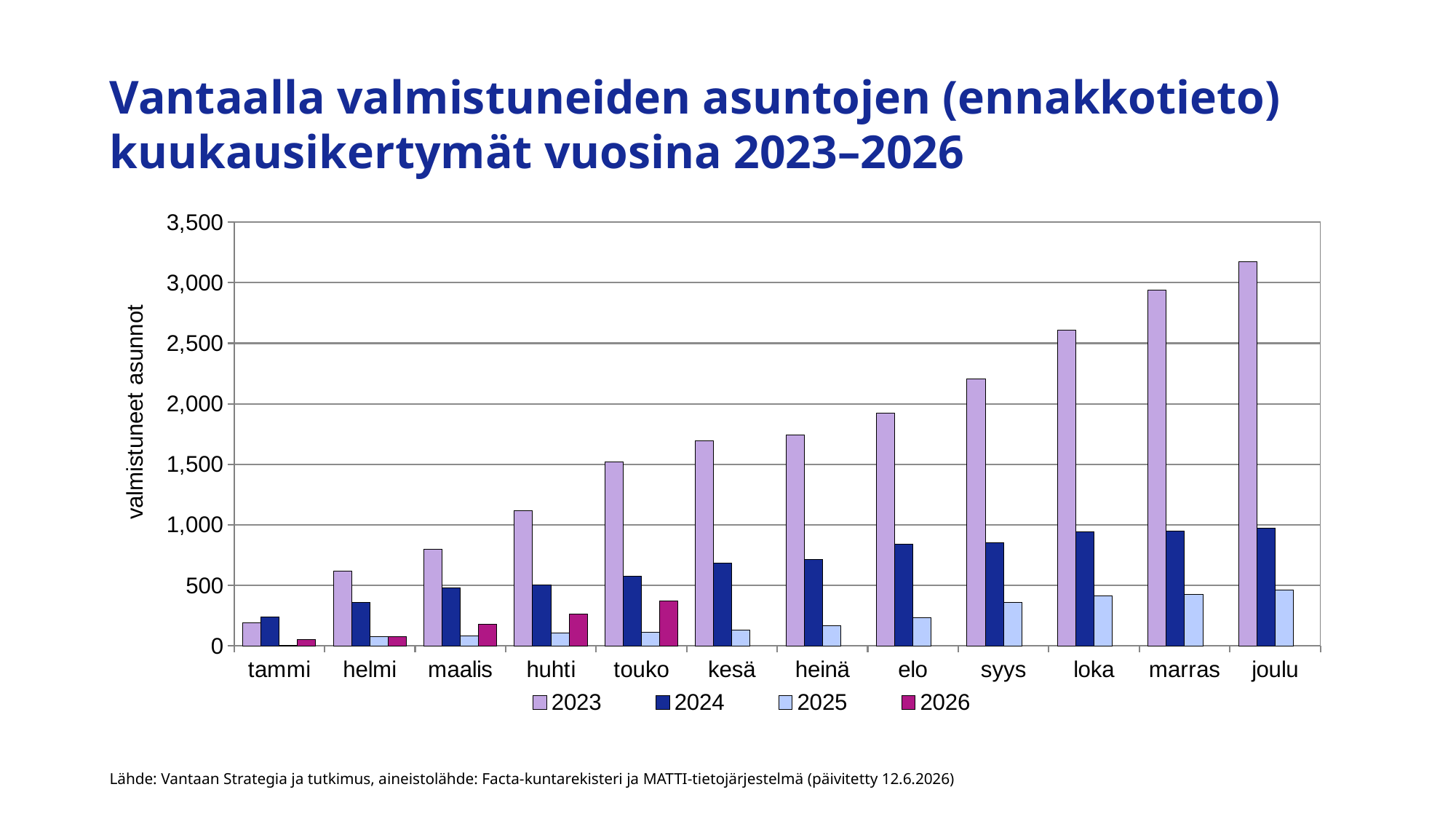
Is the 2023 value for loka greater or less than 2,500? greater For touko, which series has the larger value, 2025 or 2026? 2026 How many series does the legend list? 4 For kesä, which series has the larger value, 2023 or 2024? 2023 For how many months does the 2026 series have a bar? 5 Is the 2023 value for joulu greater or less than 3,000? greater Do the 2023 values rise or fall from tammi to joulu? rise What kind of chart is shown on the slide? bar chart How many months are shown on the x axis? 12 Is the 2023 value for syys greater or less than 2,000? greater In which month does the 2023 series reach its highest value? joulu